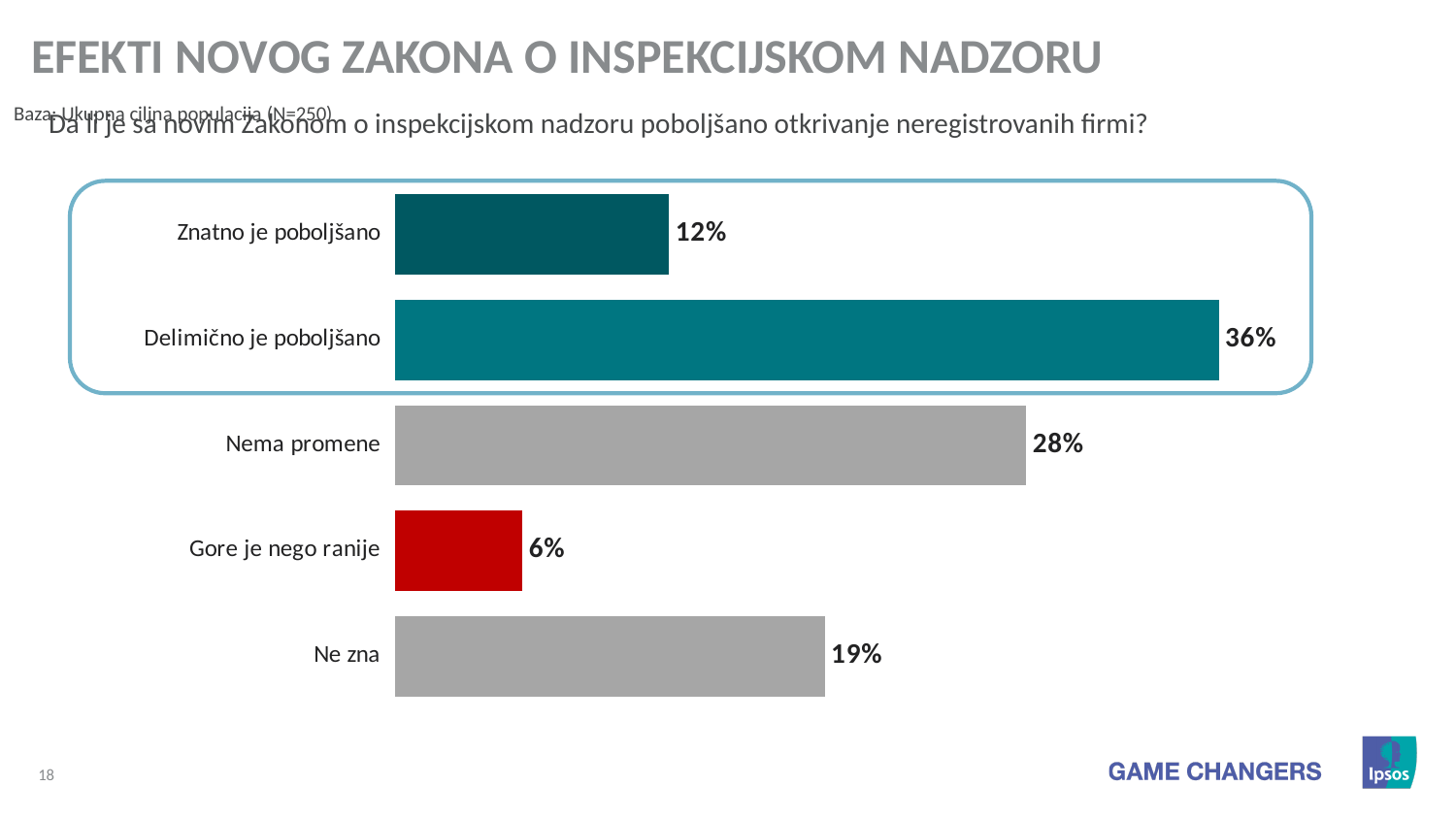
Which category has the highest value? Delimično je poboljšano What is the difference between the values for "Delimično je poboljšano" and "Nema promene"? 8% Which category has the lowest value? Gore je nego ranije What is the value for "Znatno je poboljšano"? 12% What is the value for "Delimično je poboljšano"? 36% What is the value for "Ne zna"? 19% Which is larger, the value for "Nema promene" or the value for "Ne zna"? Nema promene What is the value for "Gore je nego ranije"? 6% How many categories are shown in the chart? 5 Which category's bar is coloured red? Gore je nego ranije What is the combined value of "Znatno je poboljšano" and "Delimično je poboljšano"? 48% What kind of chart is shown on the slide? Bar chart